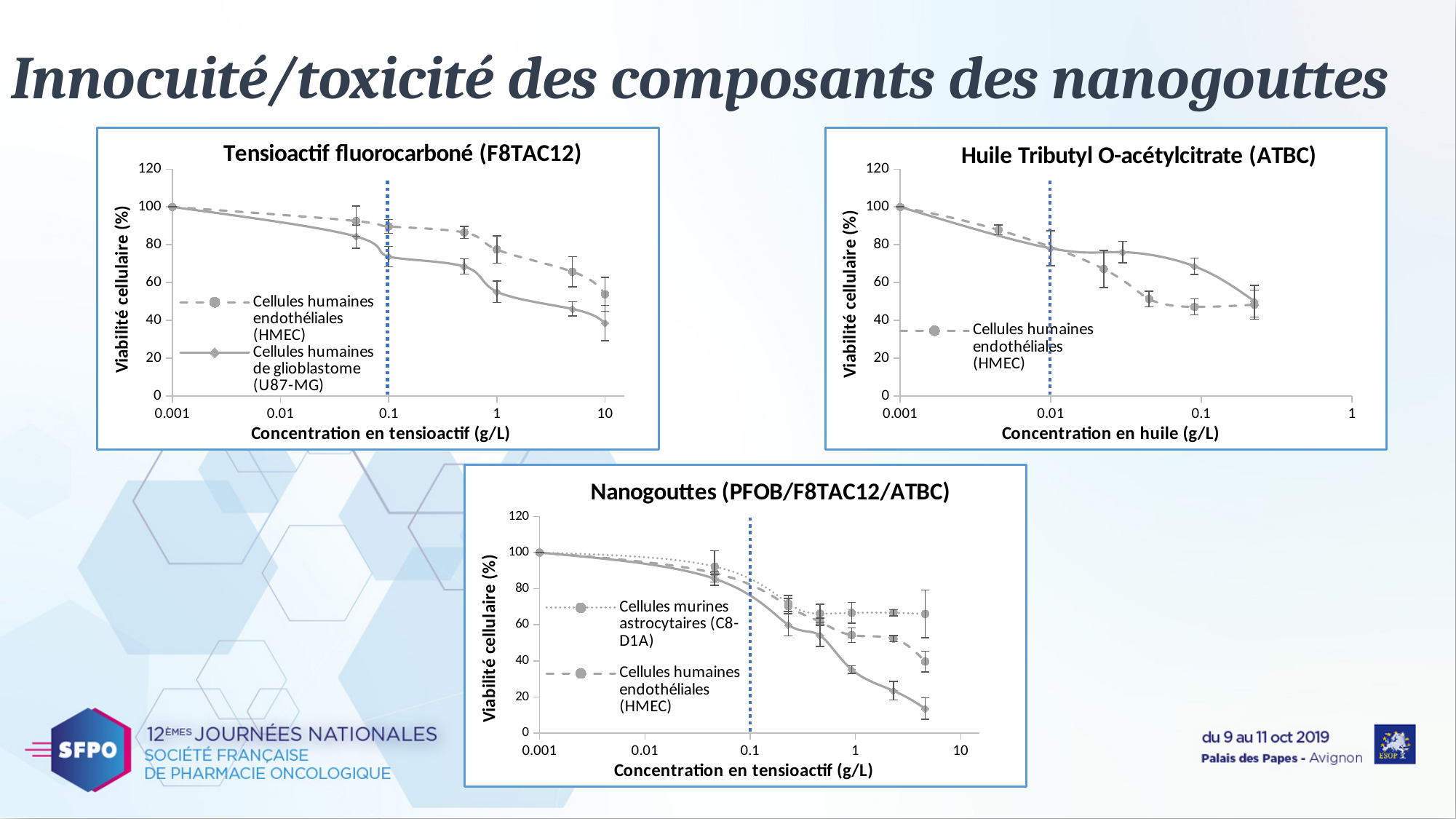
What kind of chart is the 'Tensioactif fluorocarboné (F8TAC12)' chart? line chart In the 'Tensioactif fluorocarboné (F8TAC12)' chart, is the viability of the HMEC cells at 0.1 g/L greater or less than 80? greater How many series does the legend of the 'Huile Tributyl O-acétylcitrate (ATBC)' chart list? 1 In the 'Huile Tributyl O-acétylcitrate (ATBC)' chart, what is the cell viability at 0.001 g/L? 100 How many series does the legend of the 'Tensioactif fluorocarboné (F8TAC12)' chart list? 2 How many series does the legend of the 'Nanogouttes (PFOB/F8TAC12/ATBC)' chart list? 2 In the 'Nanogouttes (PFOB/F8TAC12/ATBC)' chart, does cell viability rise or fall along the x axis? fall In the 'Nanogouttes (PFOB/F8TAC12/ATBC)' chart, at the highest concentration plotted, which cell line shows the higher viability, C8-D1A or HMEC? C8-D1A In the 'Tensioactif fluorocarboné (F8TAC12)' chart, does cell viability rise or fall as the surfactant concentration increases? fall In the 'Tensioactif fluorocarboné (F8TAC12)' chart, at 10 g/L, which cell line shows the higher viability, HMEC or U87-MG? HMEC What is the x-axis label of the 'Huile Tributyl O-acétylcitrate (ATBC)' chart? Concentration en huile (g/L) In the 'Huile Tributyl O-acétylcitrate (ATBC)' chart, is the viability at 0.1 g/L greater or less than 60? less